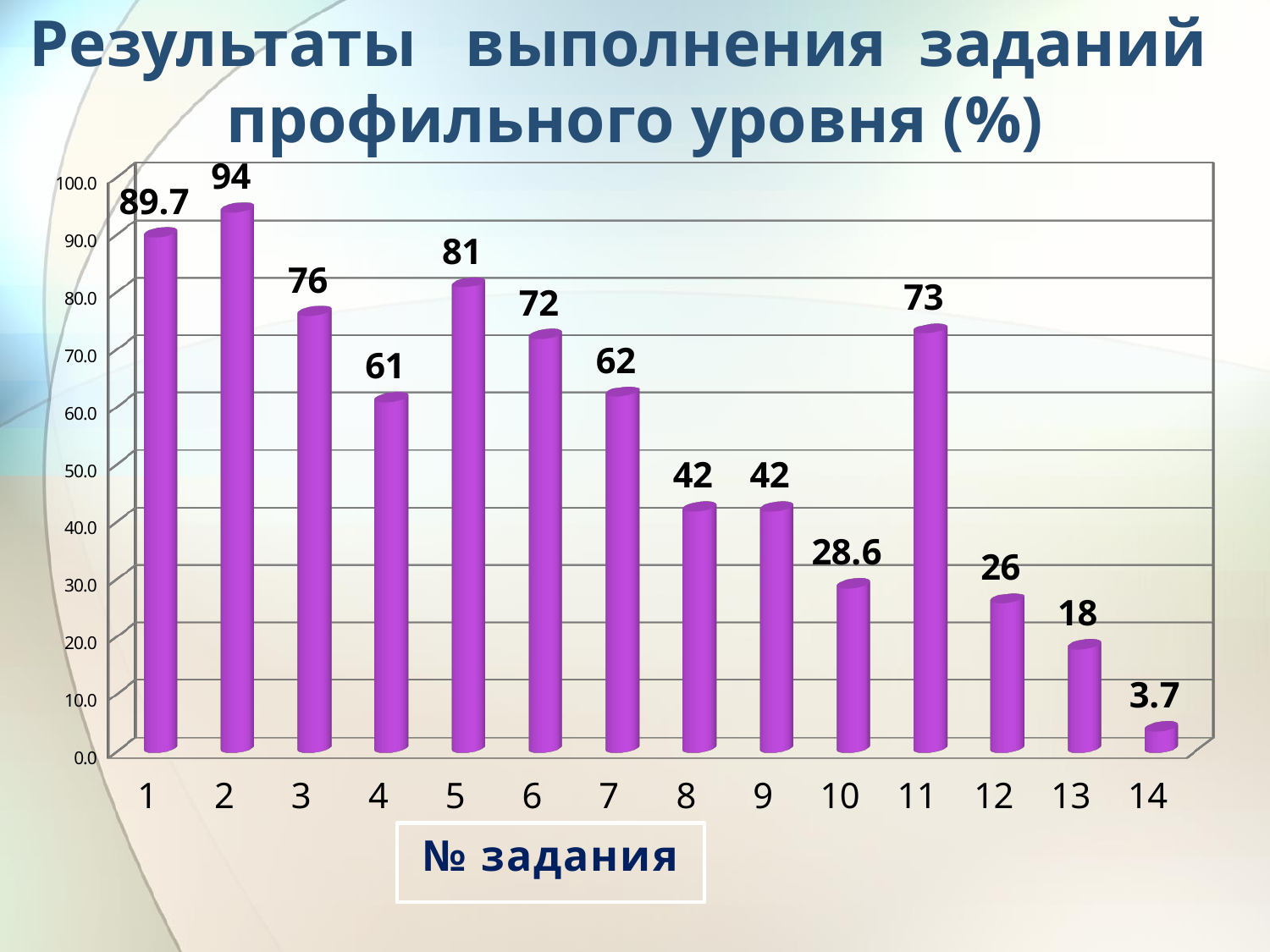
What is the difference between the values for task 5 and task 6? 9 What is the value for task 1? 89.7 What is the difference between the values for task 2 and task 14? 90.3 What kind of chart is shown on the slide? bar chart Which task has the highest value? 2 How many tasks are shown on the x axis? 14 What is the value for task 10? 28.6 What is the x-axis label of the chart? № задания Which task has the lowest value? 14 What is the value for task 11? 73 Which is larger, the value for task 4 or the value for task 7? task 7 Is the value for task 12 greater or less than 30.0? less